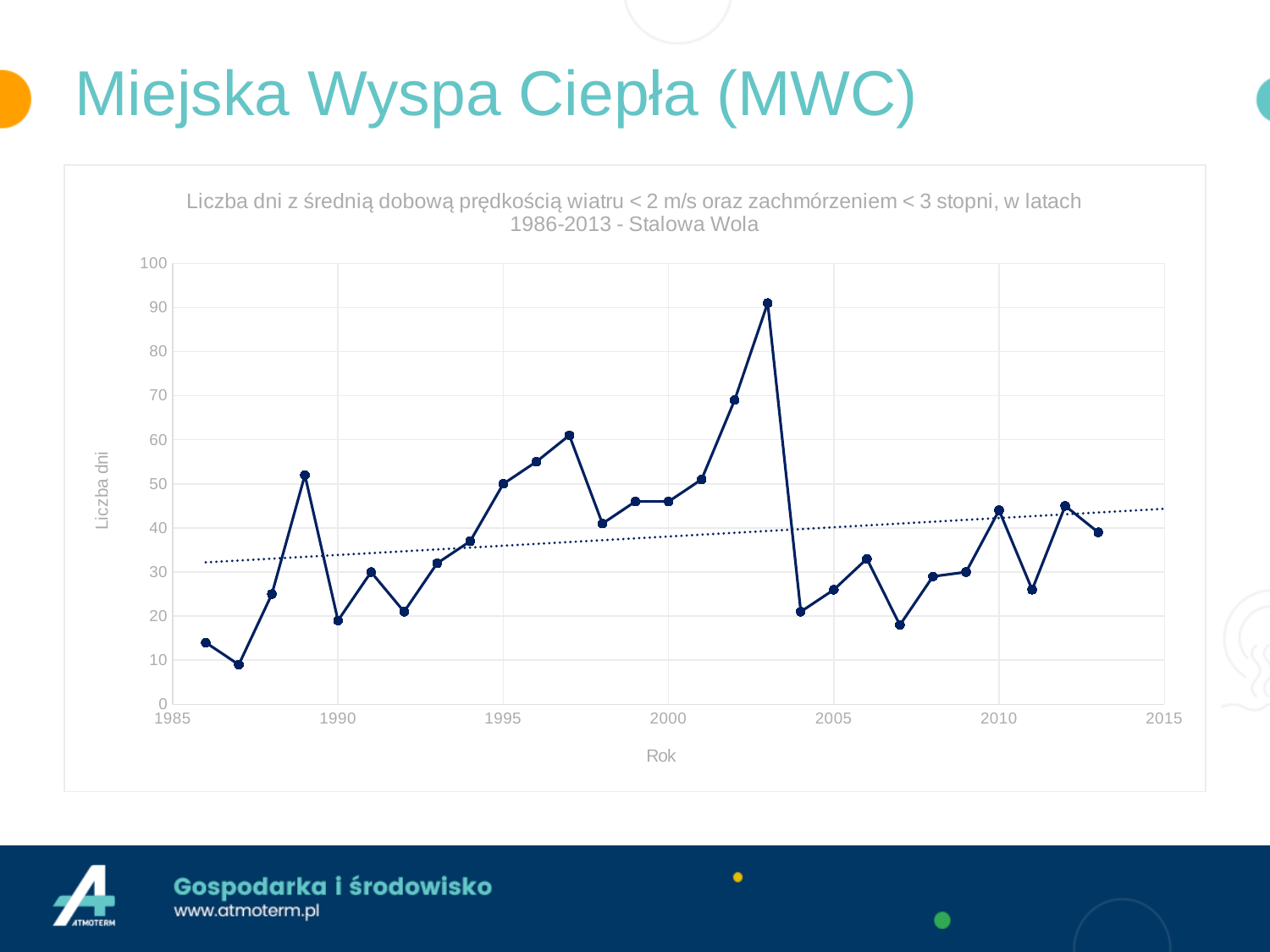
Is the value for 1987 greater or less than 20? less What is the label of the y axis? Liczba dni Which year has the larger value, 1989 or 1990? 1989 Which year has the lowest number of days in the chart? 1987 Which year has the highest number of days in the chart? 2003 What is the label of the x axis? Rok Which year has the larger value, 2010 or 2011? 2010 Is the value for 2004 greater or less than 30? less Is the value for 2003 greater or less than 80? greater Does the dotted trend line rise or fall from 1985 to 2015? rise What kind of chart is shown on the slide? line chart